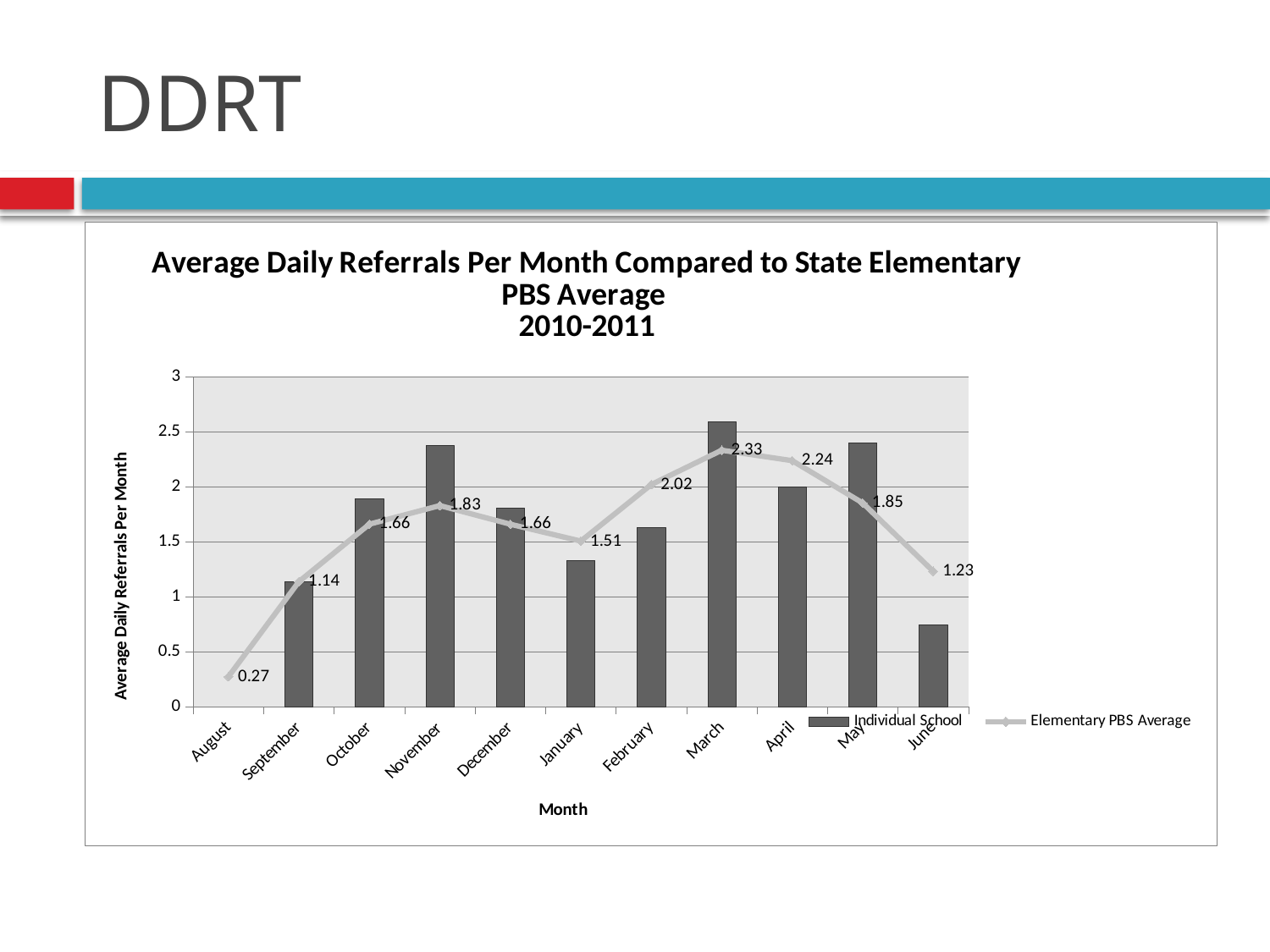
What is the Elementary PBS Average value for March? 2.33 Which is larger, the Elementary PBS Average for February or for May? February How many months are shown on the x axis? 11 Is the Individual School value for March greater or less than 2.5? greater What is the difference between the Elementary PBS Average for March and for April? 0.09 What is the Elementary PBS Average value for June? 1.23 What is the Elementary PBS Average value for August? 0.27 In which month is the Elementary PBS Average highest? March Does the Elementary PBS Average rise or fall from March to June? fall In which month is the Elementary PBS Average lowest? August Is the Individual School value for June greater or less than 1? less How many series does the legend list? 2